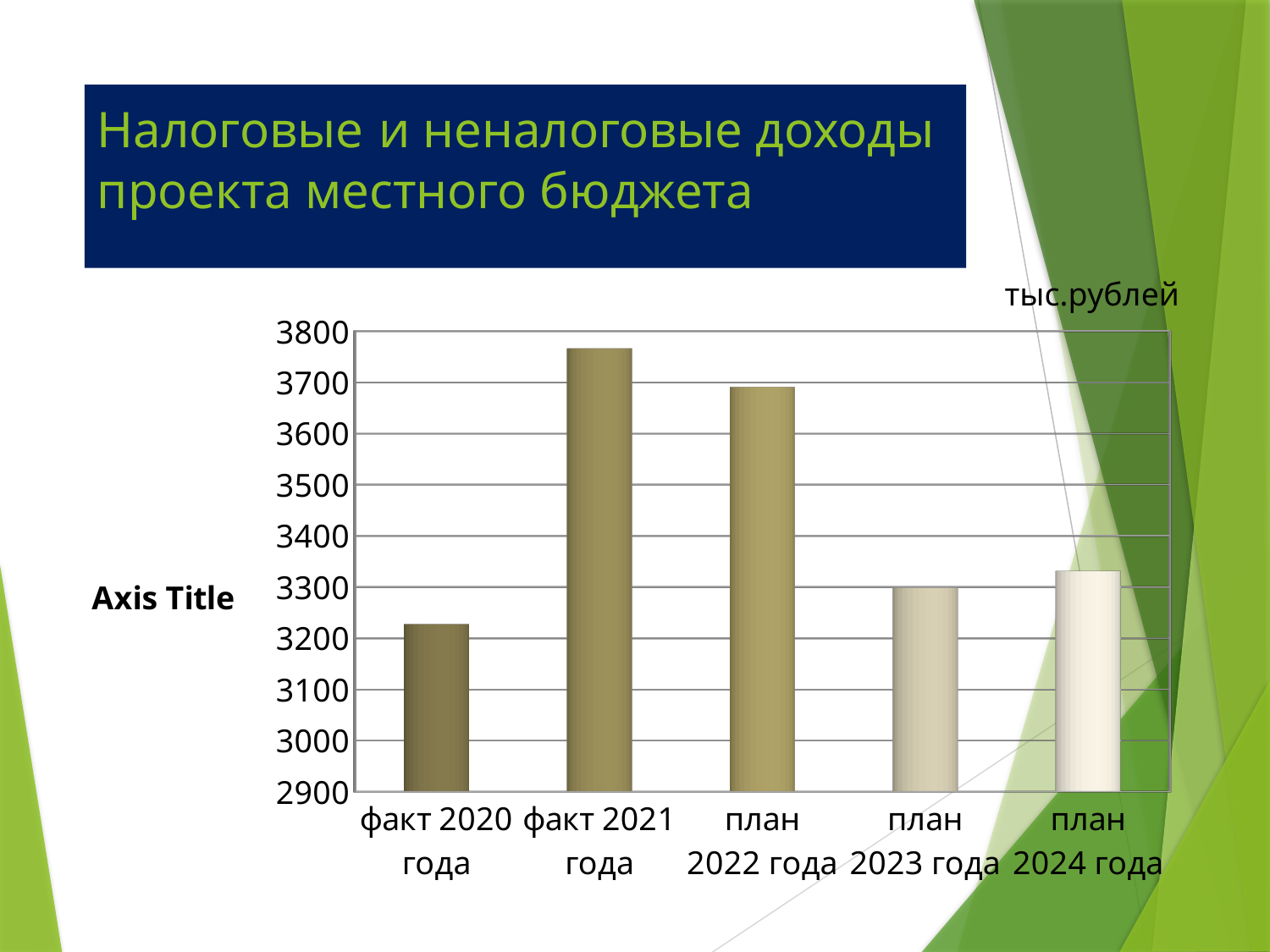
Which category has the highest value in the chart? факт 2021 года What kind of chart is shown on the slide? bar chart Which category has the lowest value in the chart? факт 2020 года What unit is indicated above the chart? тыс.рублей How many categories (bars) are shown in the chart? 5 Which is larger: the value for план 2022 года or the value for план 2023 года? план 2022 года Is the value for факт 2020 года greater or less than 3300? less Is the value for план 2022 года greater or less than 3600? greater Do the values rise or fall from факт 2021 года to план 2023 года? fall Is the value for факт 2021 года greater or less than 3700? greater Which is larger: the value for факт 2021 года or the value for план 2022 года? факт 2021 года